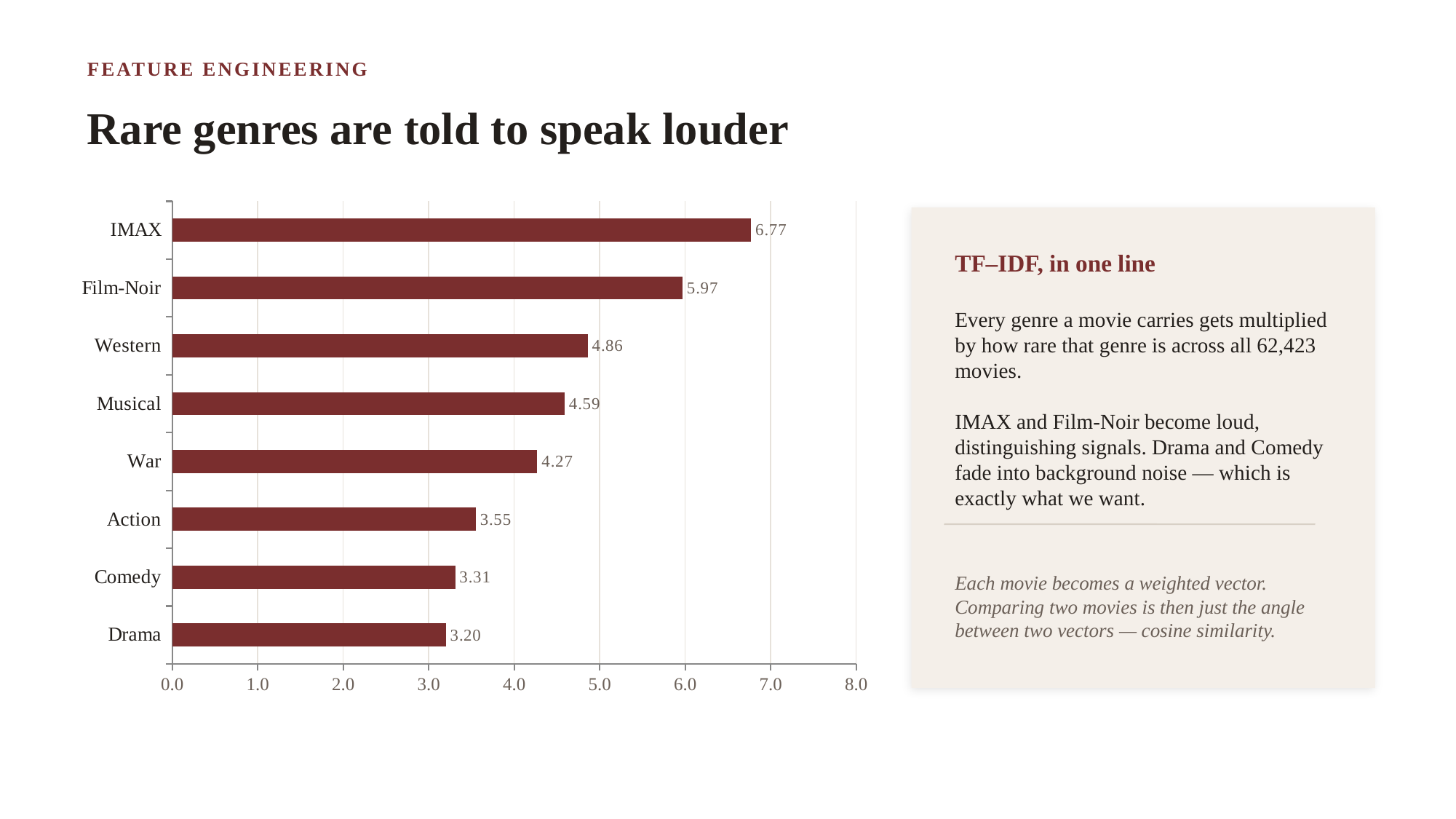
What is the value for IMAX? 6.77 Is the value for Film-Noir greater or less than 5.0? greater What is the value for Comedy? 3.31 Which has a larger value, Musical or War? Musical What is the difference between the values for Action and Drama? 0.35 What is the maximum value shown on the x axis? 8.0 Which genre has the highest value? IMAX Which genre has the lowest value? Drama What is the difference between the values for IMAX and Film-Noir? 0.80 What is the value for Western? 4.86 How many genres are shown in the chart? 8 What kind of chart is shown on the slide? Bar chart